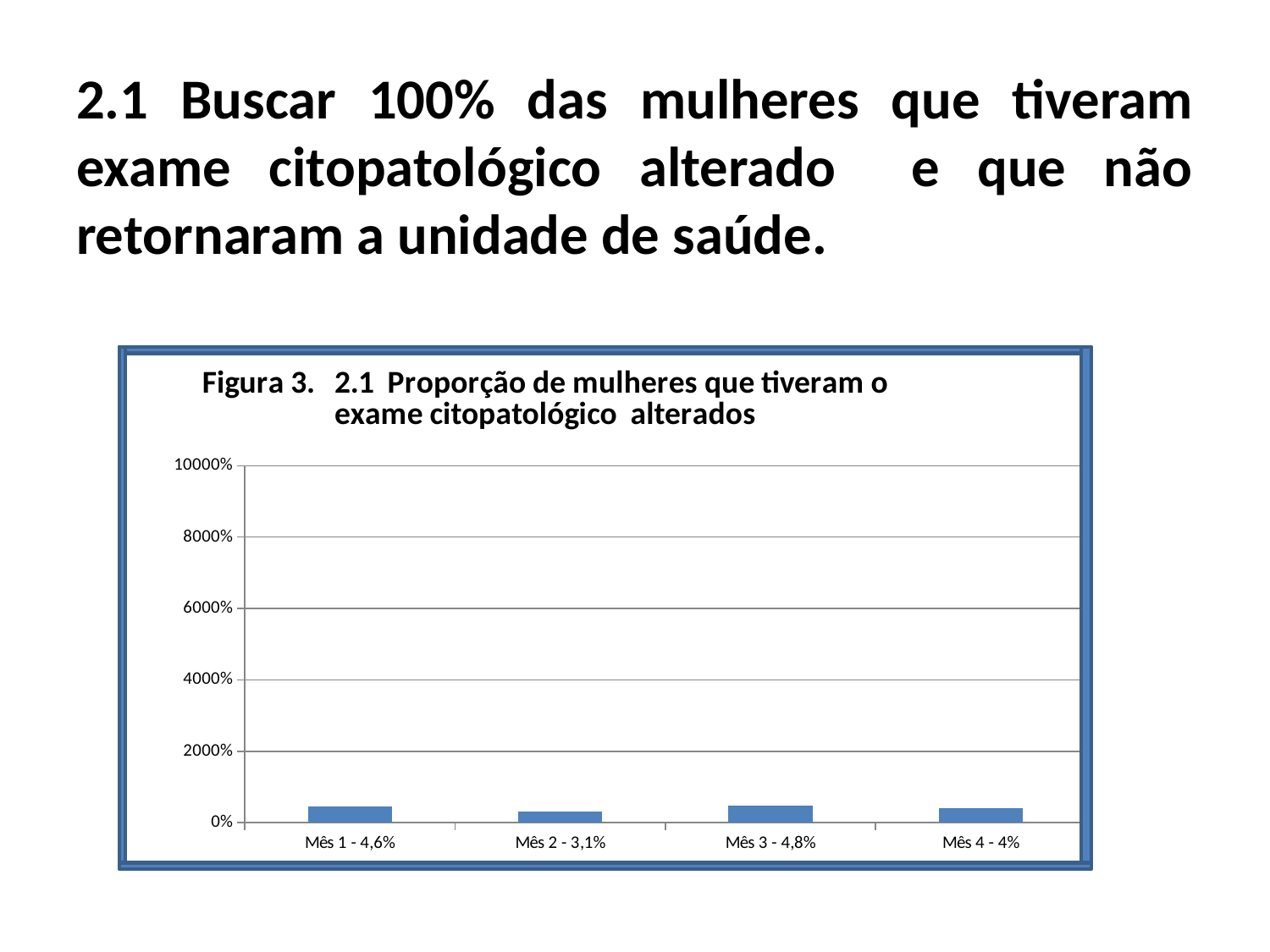
What value is shown for Mês 4 in the chart? 4% What value is shown for Mês 3 in the chart? 4,8% What is the difference between the values for Mês 3 and Mês 2? 1,7% Is the bar for Mês 3 greater or less than 2000% on the axis? less Does the value rise or fall from Mês 1 to Mês 2? fall Which month has the lowest value in the chart? Mês 2 What value is shown for Mês 1 in the chart? 4,6% What kind of chart is shown on the slide? bar chart Which is larger, the value for Mês 1 or the value for Mês 4? Mês 1 Which month has the highest value in the chart? Mês 3 How many months are shown on the x axis of the chart? 4 What value is shown for Mês 2 in the chart? 3,1%